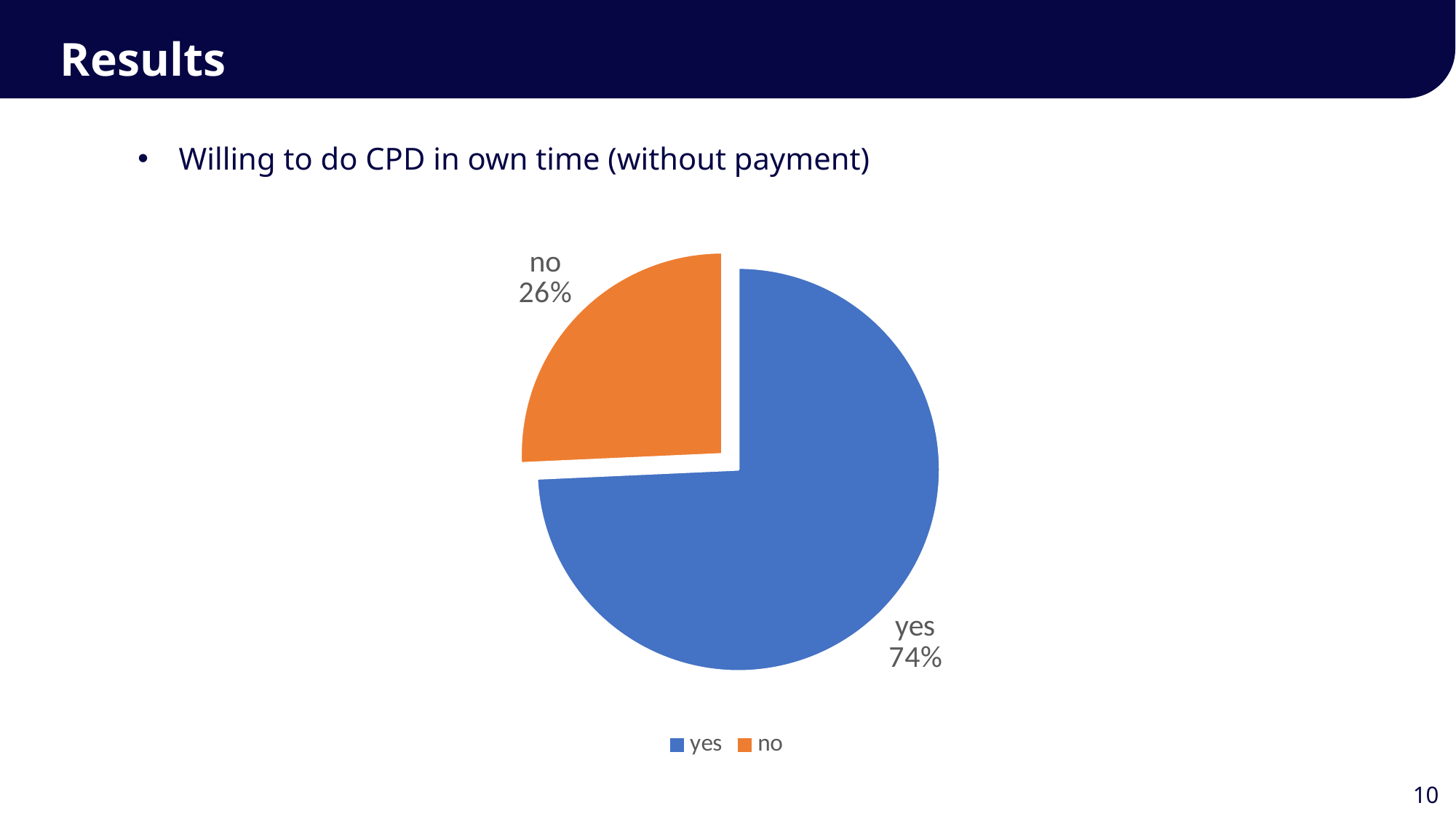
What colour is the "no" slice? orange What kind of chart is shown on the slide? pie chart Which is larger, the "yes" slice or the "no" slice? yes What colour is the "yes" slice? blue How many slices does the pie chart have? 2 Which slice of the pie is the largest? yes Which slice of the pie is the smallest? no What is the difference in percentage points between the "yes" and "no" slices? 48 How many entries does the legend list? 2 What share of the pie does the "no" slice represent? 26% What percentage of respondents answered "yes"? 74% What percentage of respondents answered "no"? 26%